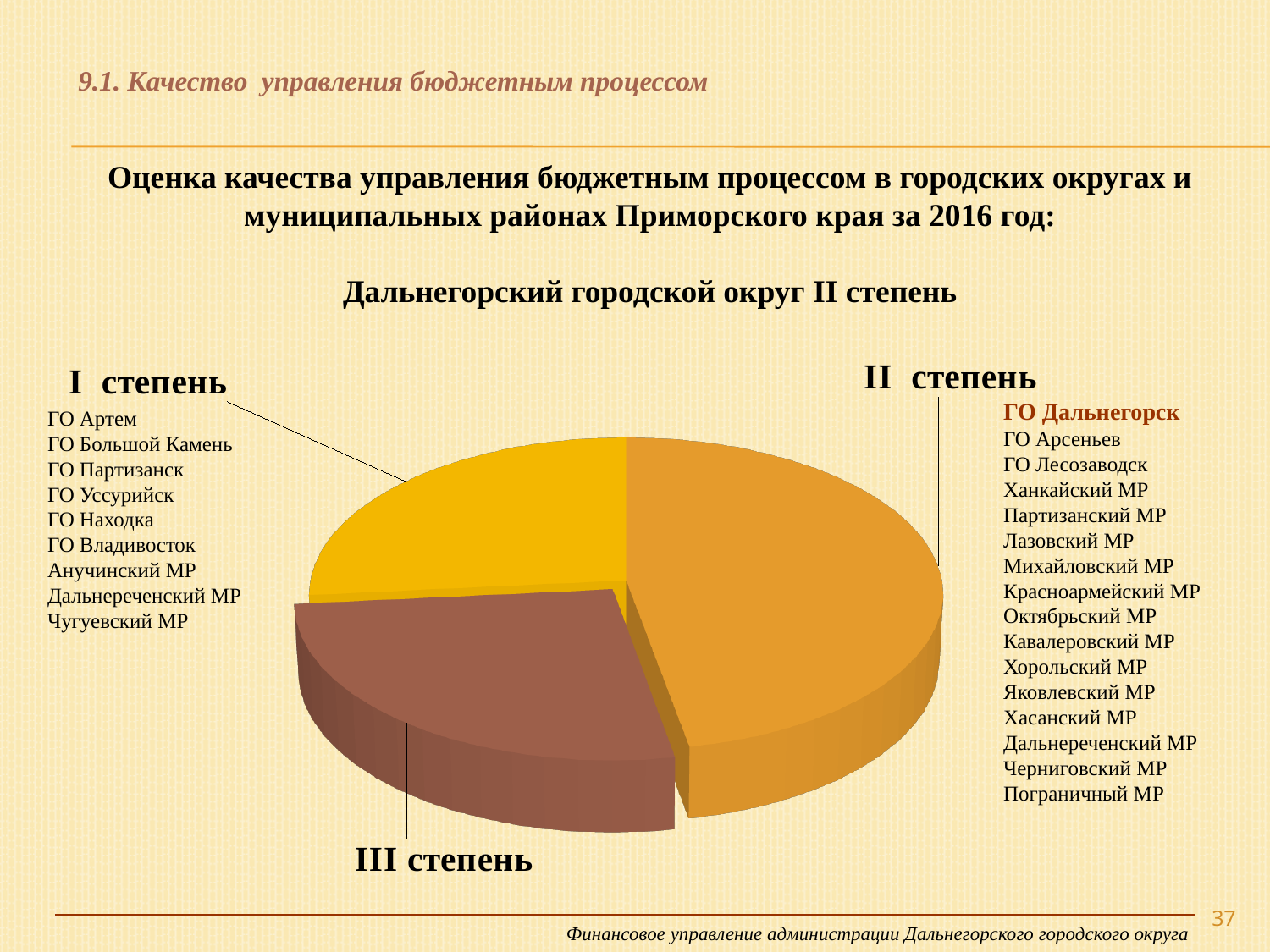
Which slice is larger, II степень or I степень? II степень What kind of chart is shown on the slide? pie chart Which slice of the pie chart is the largest? II степень Which municipality is highlighted in red in the II степень list? ГО Дальнегорск Which degree (степень) is assigned to Дальнегорский городской округ according to the slide? II степень How many municipalities are listed under I степень? 9 Which slice of the pie chart is labelled III степень? the brown slice at the bottom left How many municipalities are listed under II степень? 16 How many slices does the pie chart have? 3 Which slice is larger, II степень or III степень? II степень